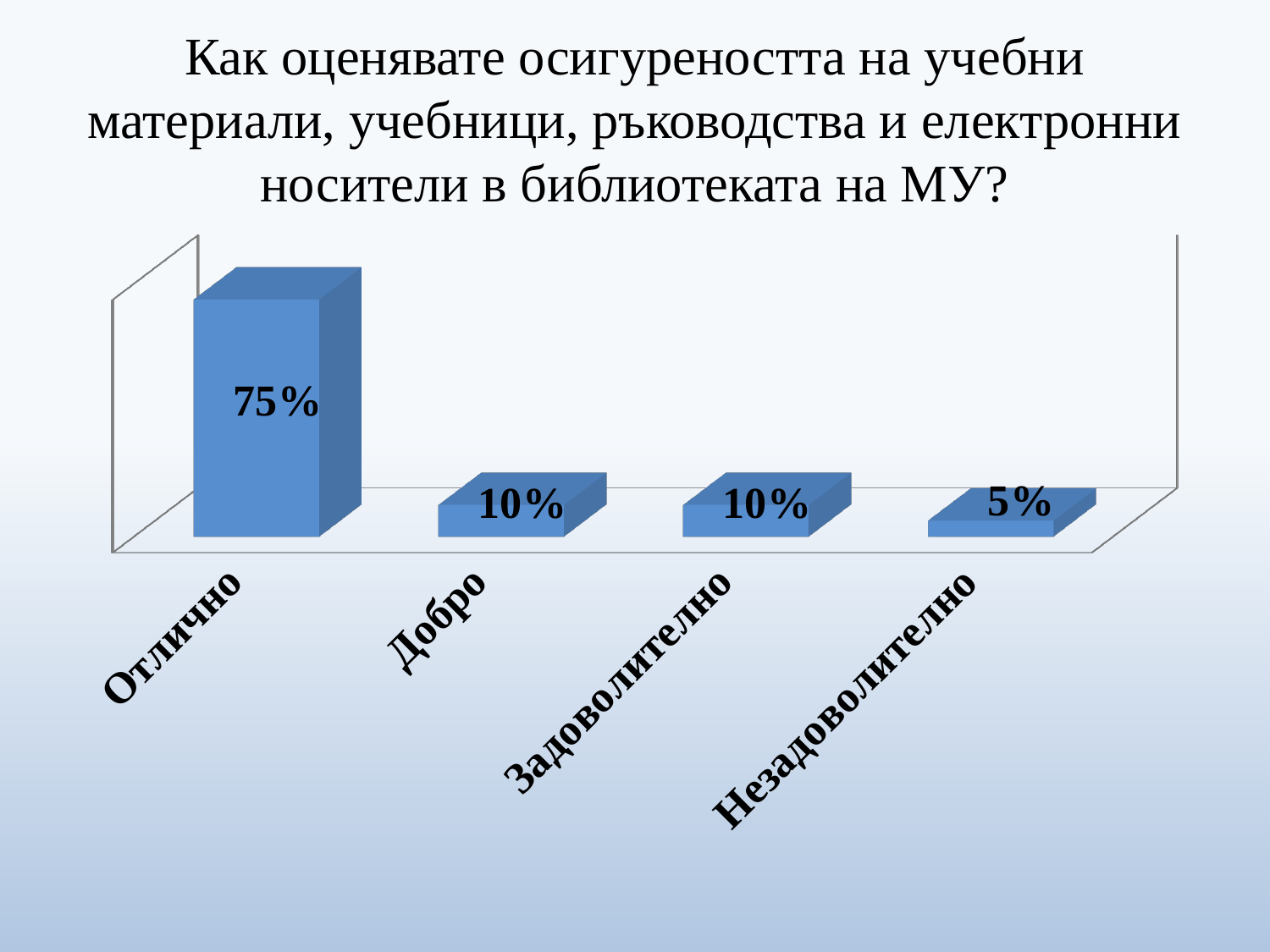
What is the value for Добро? 10% What is the value for Отлично? 75% Which category has the highest value? Отлично What is the difference between the values for Задоволително and Незадоволително? 5% What is the value for Незадоволително? 5% Which is larger, the value for Отлично or the value for Незадоволително? Отлично Which category has the lowest value? Незадоволително How many categories are shown in the chart? 4 What is the value for Задоволително? 10% What kind of chart is shown on the slide? Bar chart Do the values rise or fall from Отлично to Незадоволително along the x axis? Fall What is the difference between the values for Отлично and Добро? 65%